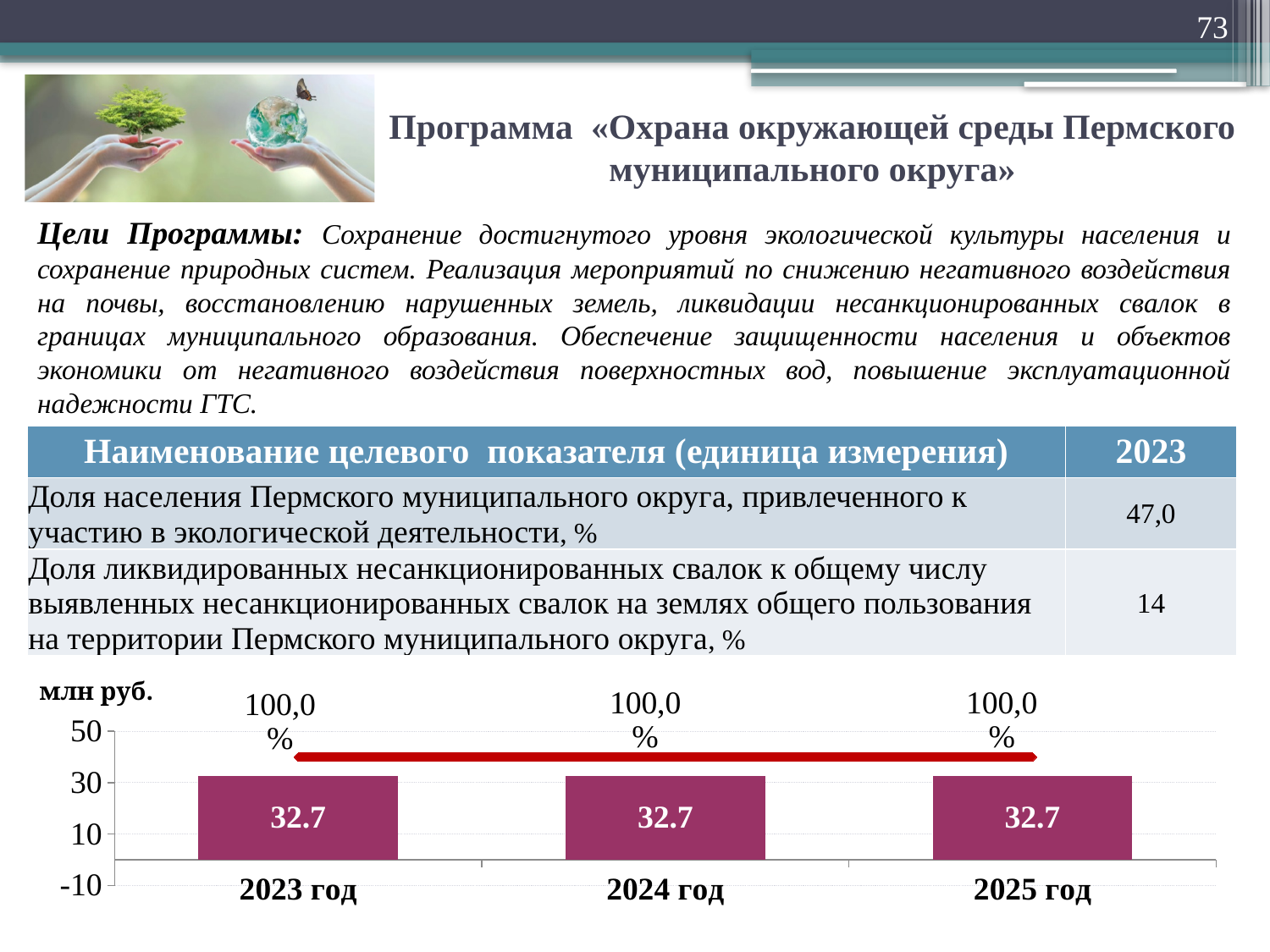
What unit of measurement is shown at the top left of the bar chart? млн руб. Is the value for 2024 год in the bar chart greater or less than 50? less What is the value for 2023 год in the bar chart? 32.7 What is the total of the three bar values in the chart (2023, 2024 and 2025)? 98.1 What percentage label is shown above each bar on the red line in the chart? 100,0 % How many categories (years) are shown on the x axis of the bar chart? 3 What kind of chart is shown at the bottom of the slide? combination bar and line chart Is the value for 2023 год in the bar chart greater or less than 10? greater What is the difference between the values for 2023 год and 2025 год in the bar chart? 0 Do the bar values rise, fall or stay the same from 2023 год to 2025 год? stay the same What is the value for 2024 год in the bar chart? 32.7 What is the value for 2025 год in the bar chart? 32.7